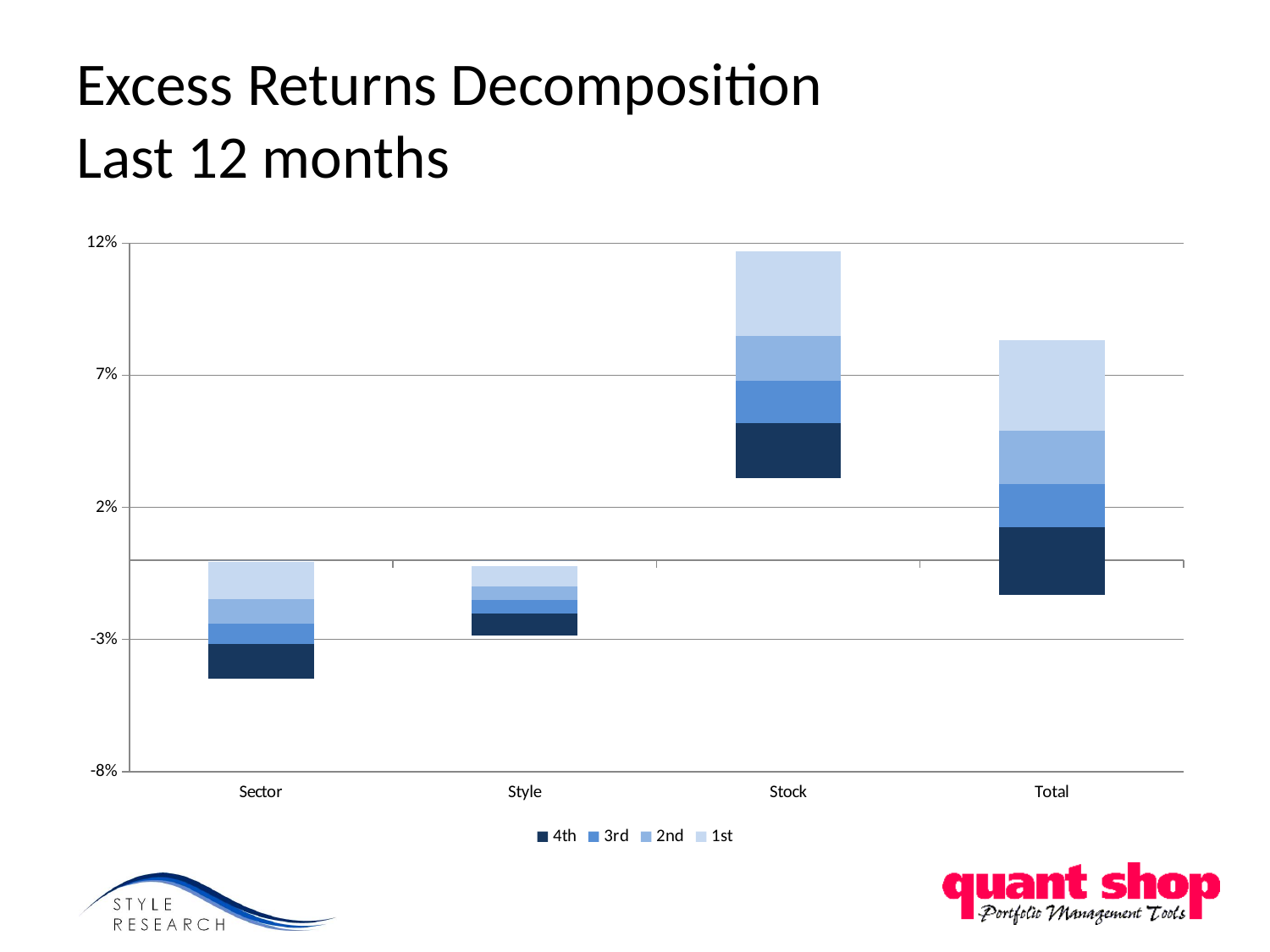
Is the top of the stacked bar for Total greater or less than 7%? greater Is the bottom of the stacked bar for Stock greater or less than 2%? greater Which category has the highest stacked bar top? Stock How many series does the chart's legend list? 4 What are the series names listed in the chart's legend? 4th, 3rd, 2nd, 1st Is the top of the stacked bar for Stock greater or less than 7%? greater How many categories are shown on the x axis of the chart? 4 What is the title of the slide containing the chart? Excess Returns Decomposition Last 12 months What kind of chart is shown on the slide? Stacked bar chart Which stacked bar reaches higher, Stock or Total? Stock Which category's bar extends lowest below zero? Sector